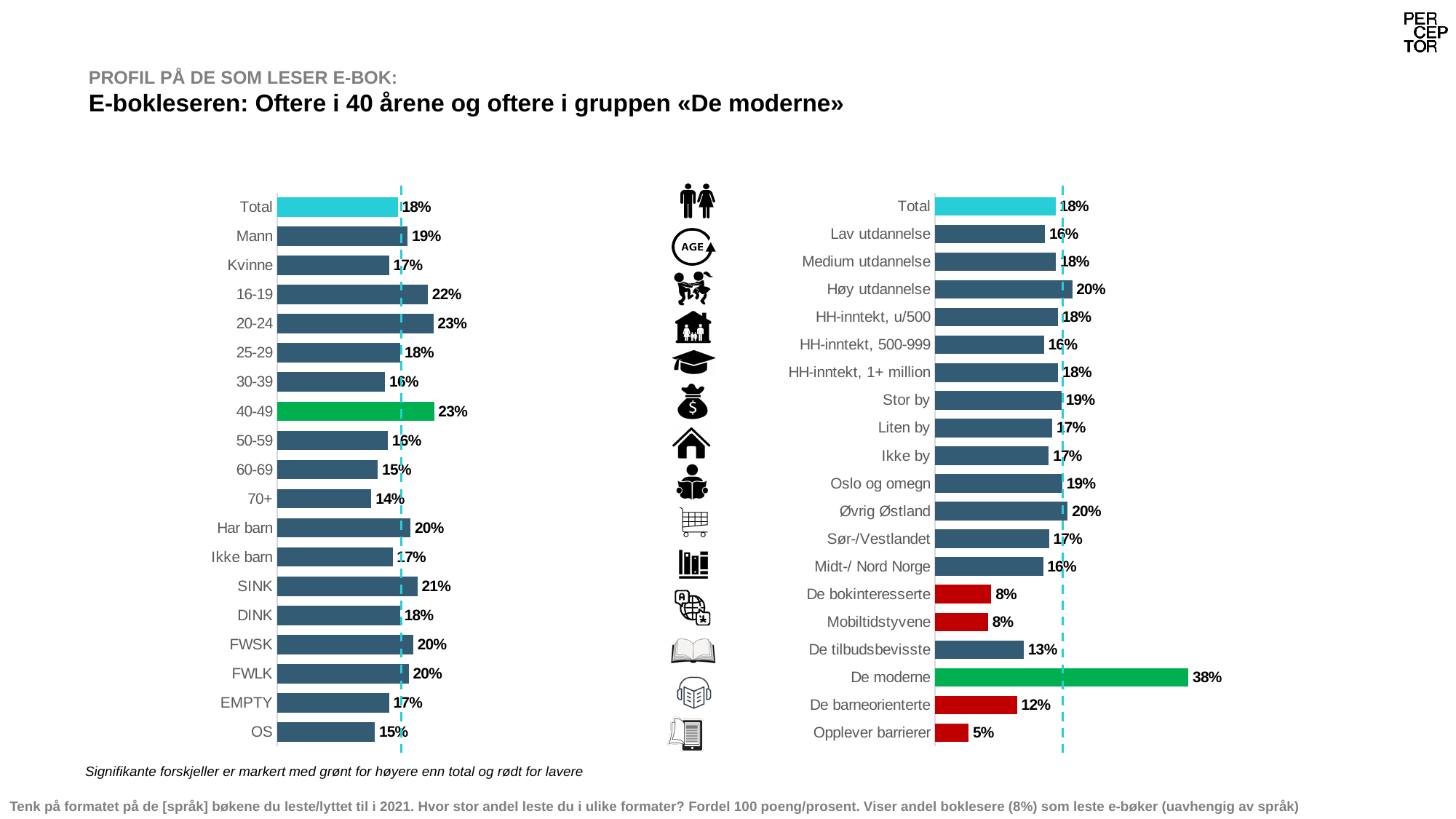
In the right chart, what is the difference between De moderne and Total? 20% In the left chart, which is larger, the value for Mann or the value for Kvinne? Mann In the left chart, which category has the lowest value? 70+ In the right chart, what is the value for De moderne? 38% In the left chart, what is the value for 40-49? 23% In the left chart, what is the value for SINK? 21% How many categories are shown in the right chart? 20 How many categories are shown in the left chart? 19 In the right chart, which category has the lowest value? Opplever barrierer What type of chart is the left chart? Bar chart In the right chart, which category has the highest value? De moderne In the right chart, what is the value for Høy utdannelse? 20%